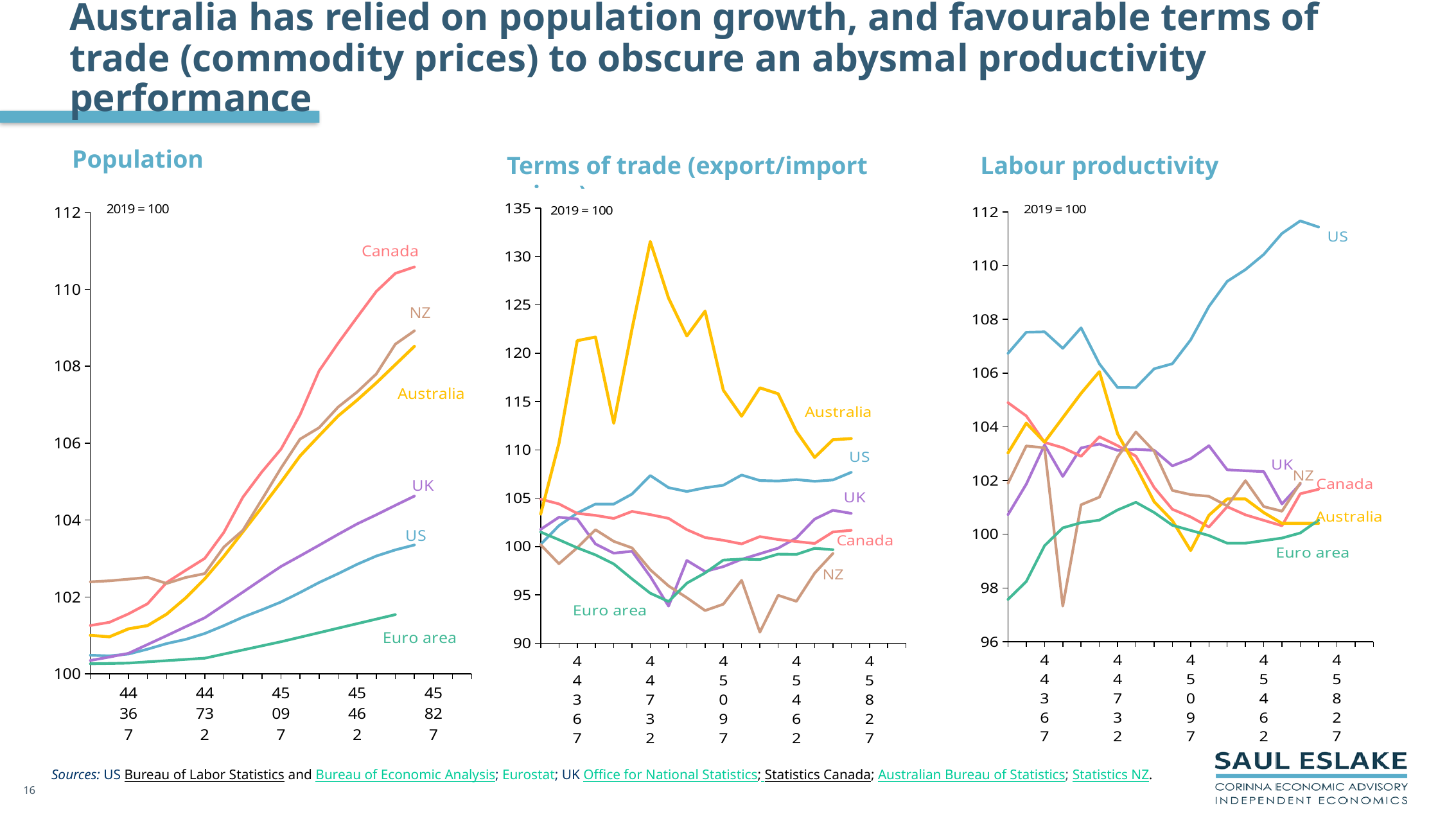
In the Population chart, which series is lowest at the end of the period? Euro area In the Labour productivity chart, which series is highest at the end of the period? US In the Terms of trade chart, is the lowest point of the NZ line greater or less than 95? less In the Population chart, is the final value for Euro area greater or less than 102? less In the Population chart, is the final value for Canada greater or less than 110? greater What base year is used for the indexes in all three charts (index = 100)? 2019 How many charts are shown on the slide? 3 In the Population chart, how many series (countries/regions) are plotted? 6 What kind of chart is the Population chart? line chart In the Terms of trade chart, which series reaches the highest value? Australia In the Population chart, which series is highest at the end of the period? Canada